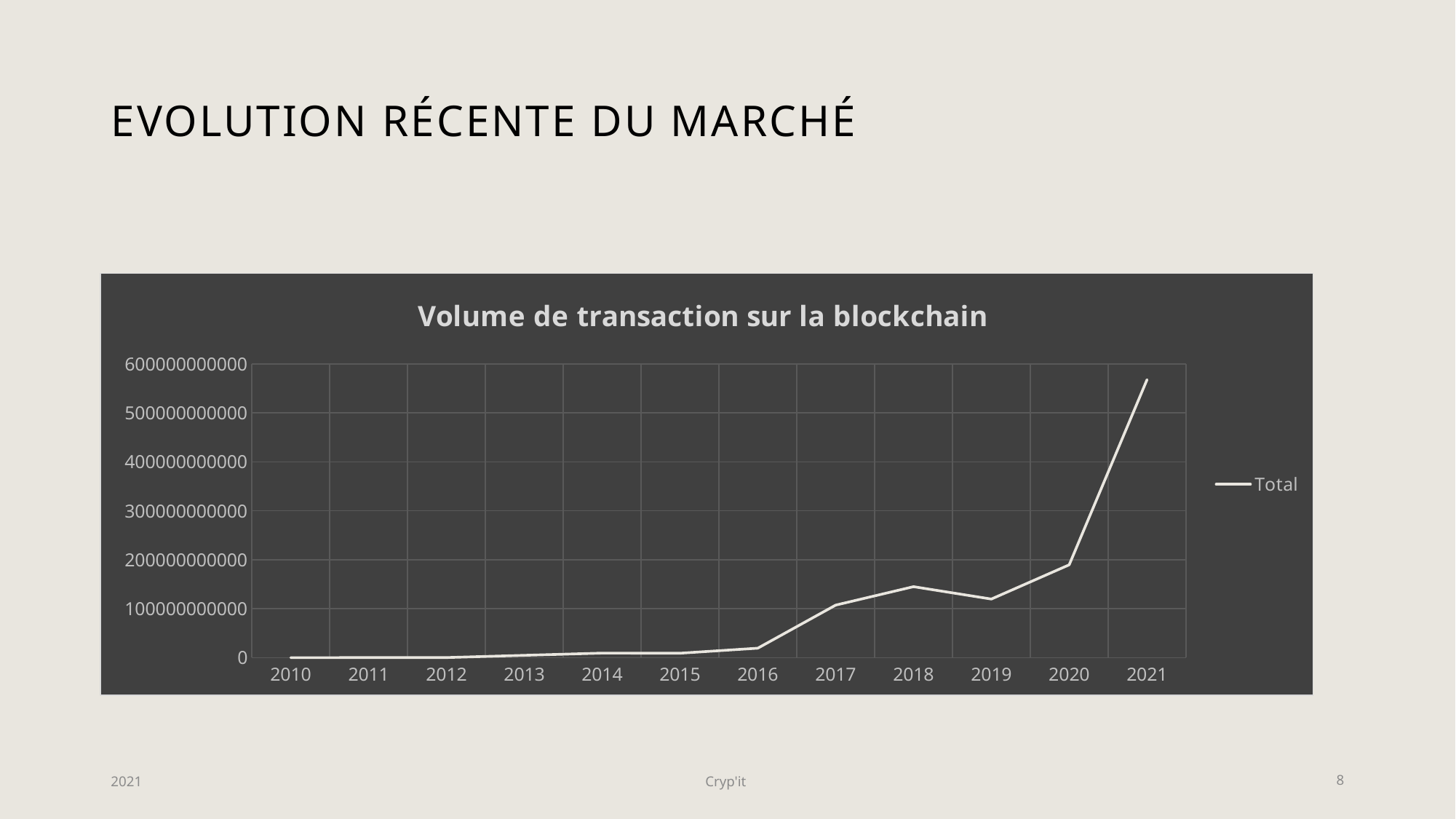
What is the title of the chart? Volume de transaction sur la blockchain How many series does the legend list? 1 Is the value for 2016 greater or less than 100000000000? less How many years are plotted along the x axis? 12 Which year has the larger value, 2018 or 2019? 2018 What kind of chart is shown on the slide? line chart Which year has the highest value for Total? 2021 Overall, do the values rise or fall from 2010 to 2021? rise Is the value for 2019 greater or less than 100000000000? greater Is the value for 2021 greater or less than 500000000000? greater What is the name of the series shown in the legend? Total